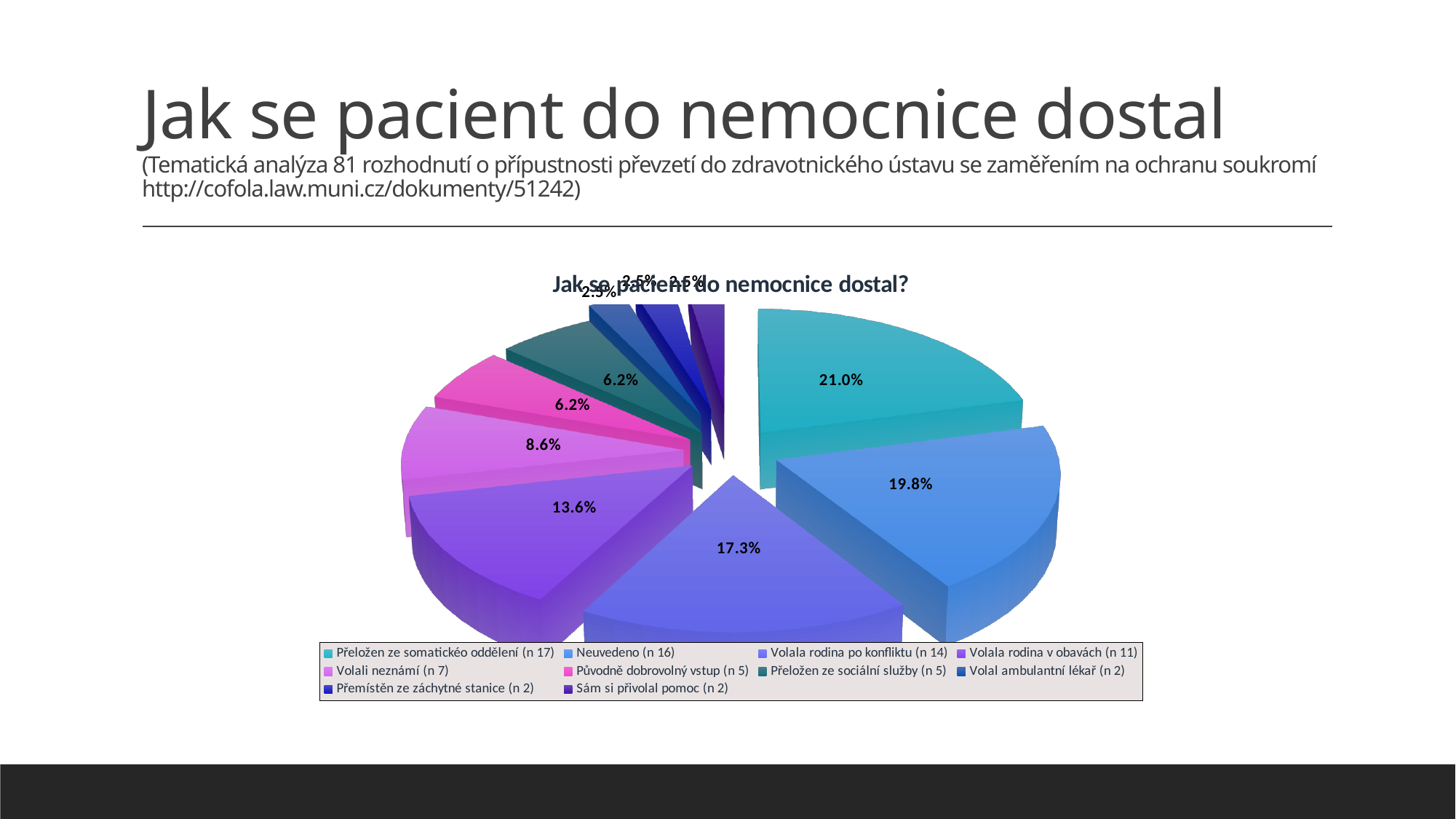
How many categories does the legend list? 10 Which category has the largest share of the pie? Přeložen ze somatickéo oddělení (n 17) What type of chart is shown on the slide? Pie chart What percentage is shown for "Neuvedeno (n 16)"? 19.8% Which is larger, the share for "Volala rodina v obavách (n 11)" or for "Volali neznámí (n 7)"? Volala rodina v obavách (n 11) What percentage is shown for "Původně dobrovolný vstup (n 5)"? 6.2% What percentage is shown for "Volali neznámí (n 7)"? 8.6% What percentage is shown for "Volala rodina v obavách (n 11)"? 13.6% What share of the pie does "Přeložen ze somatickéo oddělení (n 17)" represent? 21.0% What percentage is shown for "Volala rodina po konfliktu (n 14)"? 17.3% What is the difference in percentage points between "Přeložen ze somatickéo oddělení (n 17)" and "Neuvedeno (n 16)"? 1.2 What is the title of the chart? Jak se pacient do nemocnice dostal?